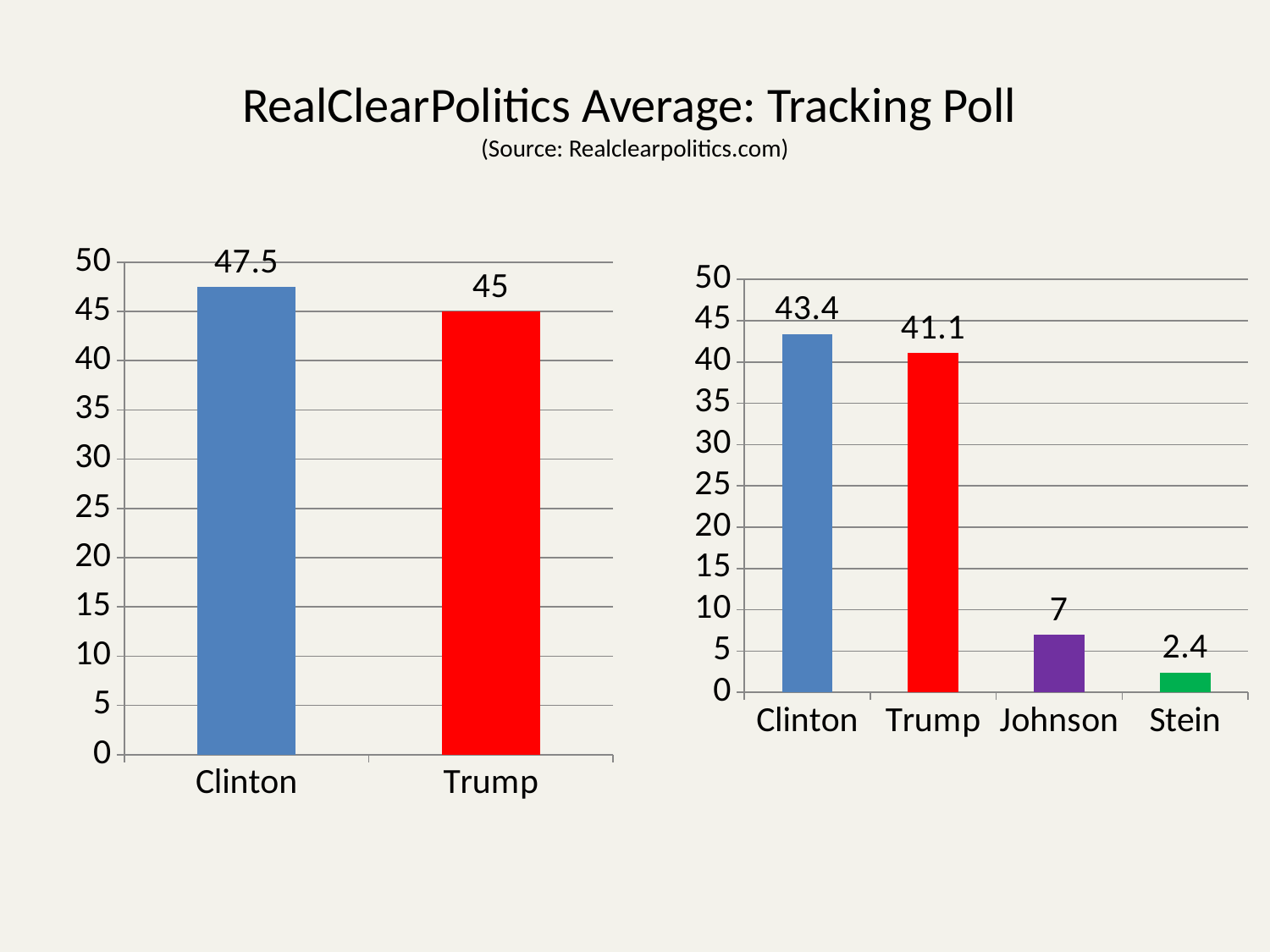
In the right chart, what is the value for Stein? 2.4 In the left chart, what is the difference between Clinton's and Trump's values? 2.5 What kind of chart is the right chart? Bar chart In the right chart, what is the value for Johnson? 7 In the left chart, how many categories are shown? 2 In the right chart, which category has the lowest value? Stein In the right chart, what is the difference between Clinton's and Trump's values? 2.3 In the right chart, which category has the highest value? Clinton In the left chart, what is the value for Clinton? 47.5 What is the title of the slide? RealClearPolitics Average: Tracking Poll In the left chart, what is the value for Trump? 45 In the right chart, how many categories are shown? 4